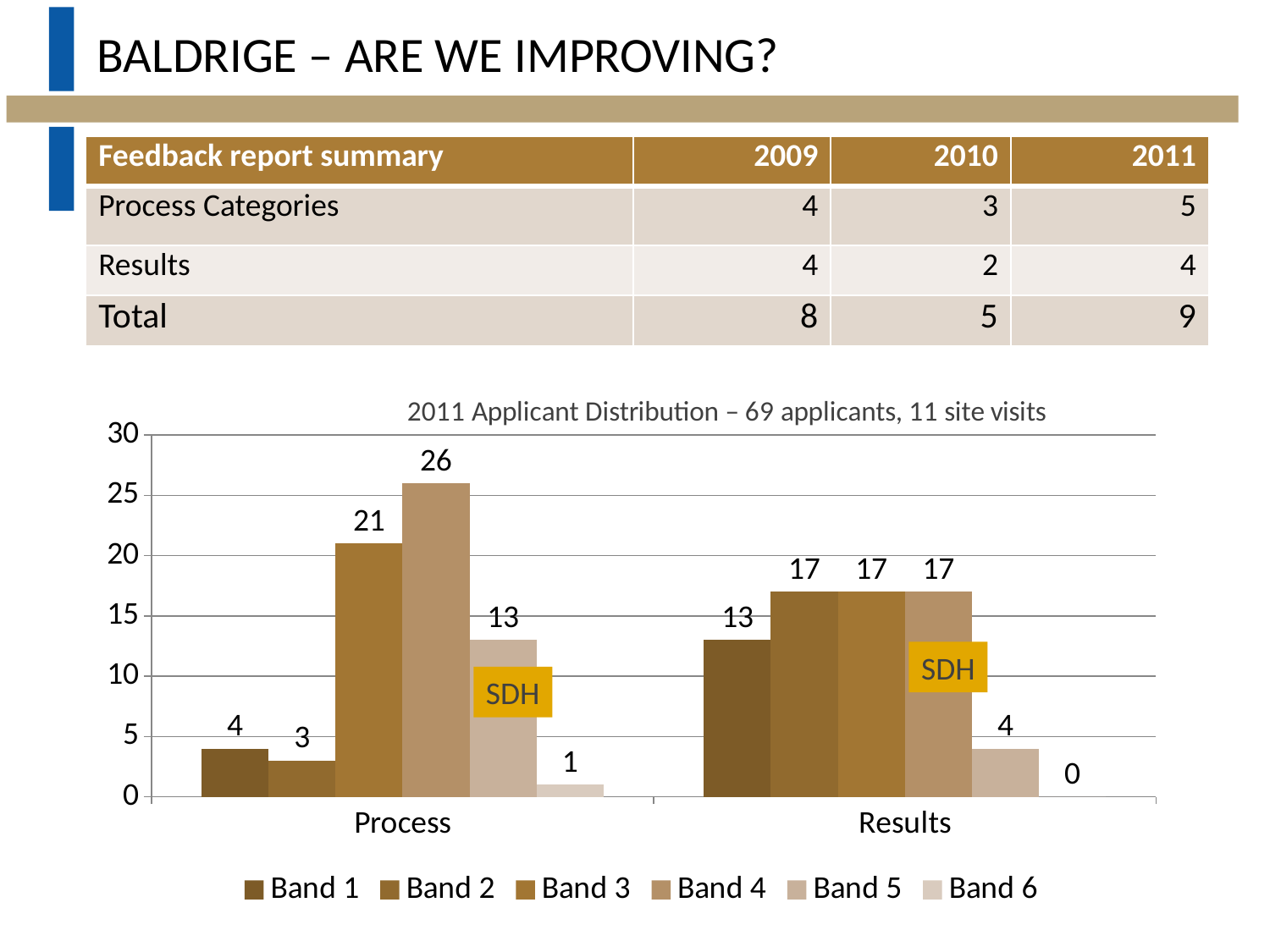
What is the title of the chart? 2011 Applicant Distribution – 69 applicants, 11 site visits How many categories are shown on the x axis? 2 What is the difference between Band 4 and Band 3 in the Process category? 5 What kind of chart is shown on the slide? bar chart What is the value for Band 1 in the Results category? 13 How many series does the legend list? 6 Which band has the highest value in the Process category? Band 4 What is the value for Band 4 in the Process category? 26 Is the value for Band 3 in the Process category greater or less than 20? greater What is the value for Band 6 in the Results category? 0 Which is larger: Band 5 in Process or Band 5 in Results? Band 5 in Process Which band has the lowest value in the Process category? Band 6